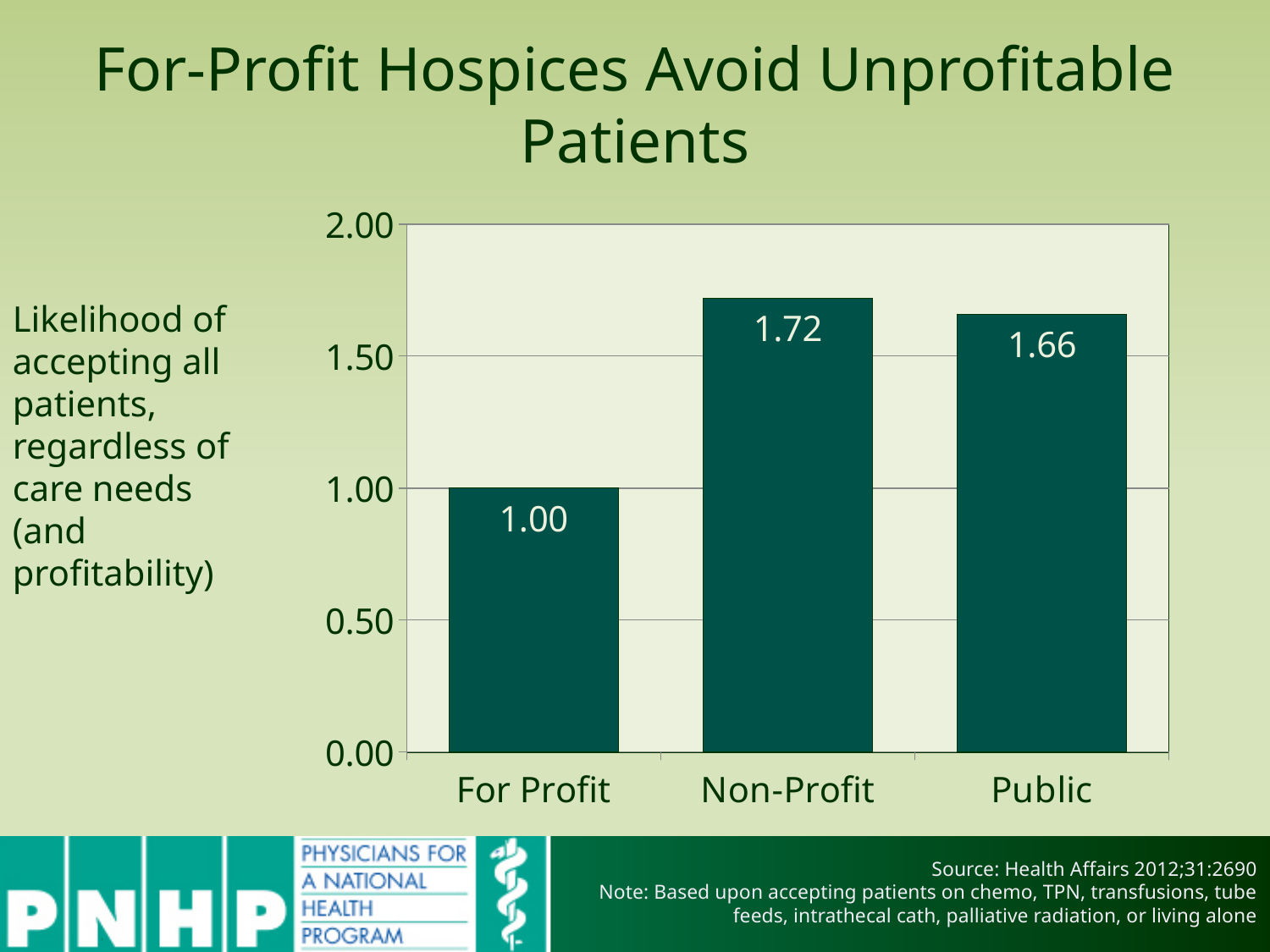
What is the value for Non-Profit? 1.72 Which is larger, the value for Public or the value for For Profit? Public What is the value for For Profit? 1.00 What kind of chart is shown on the slide? bar chart Is the value for Public greater or less than 1.50? greater What is the title of the slide containing the chart? For-Profit Hospices Avoid Unprofitable Patients How many categories are shown on the x axis? 3 What is the value for Public? 1.66 Which category has the highest value? Non-Profit Which category has the lowest value? For Profit What is the difference between the Non-Profit and Public values? 0.06 What is the difference between the Non-Profit and For Profit values? 0.72